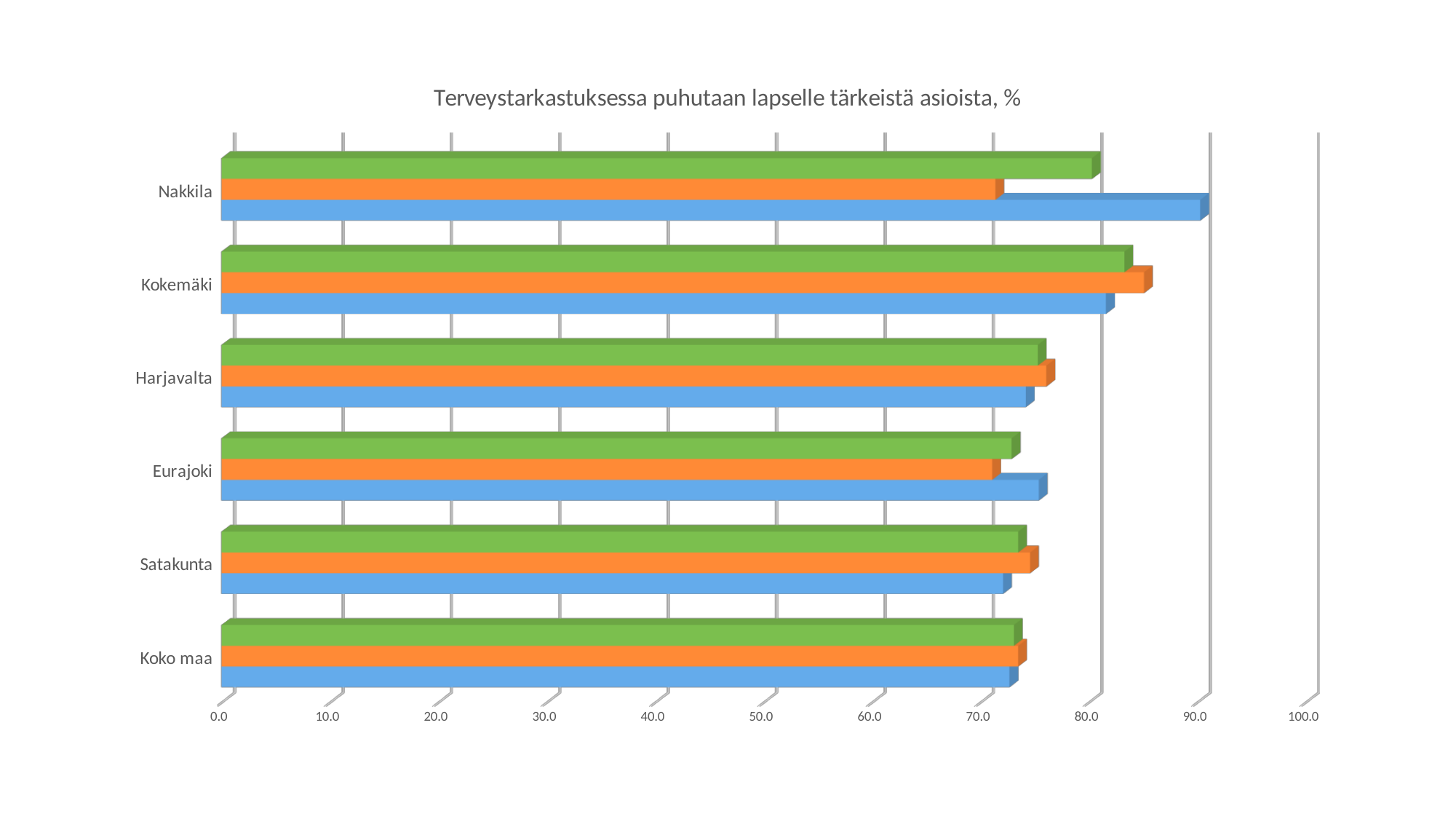
What kind of chart is shown on the slide? bar chart What is the title of the chart? Terveystarkastuksessa puhutaan lapselle tärkeistä asioista, % For Nakkila, which is larger: the blue bar or the orange bar? the blue bar Is the blue bar for Eurajoki greater or less than 70? greater Which category has the longest blue bar? Nakkila How many categories are shown on the vertical axis of the chart? 6 Is the blue bar for Nakkila greater or less than 80? greater Is the blue bar for Koko maa greater or less than 80? less What is the highest value shown on the horizontal axis? 100.0 For Kokemäki, which is larger: the orange bar or the blue bar? the orange bar Which category has the longest orange bar? Kokemäki